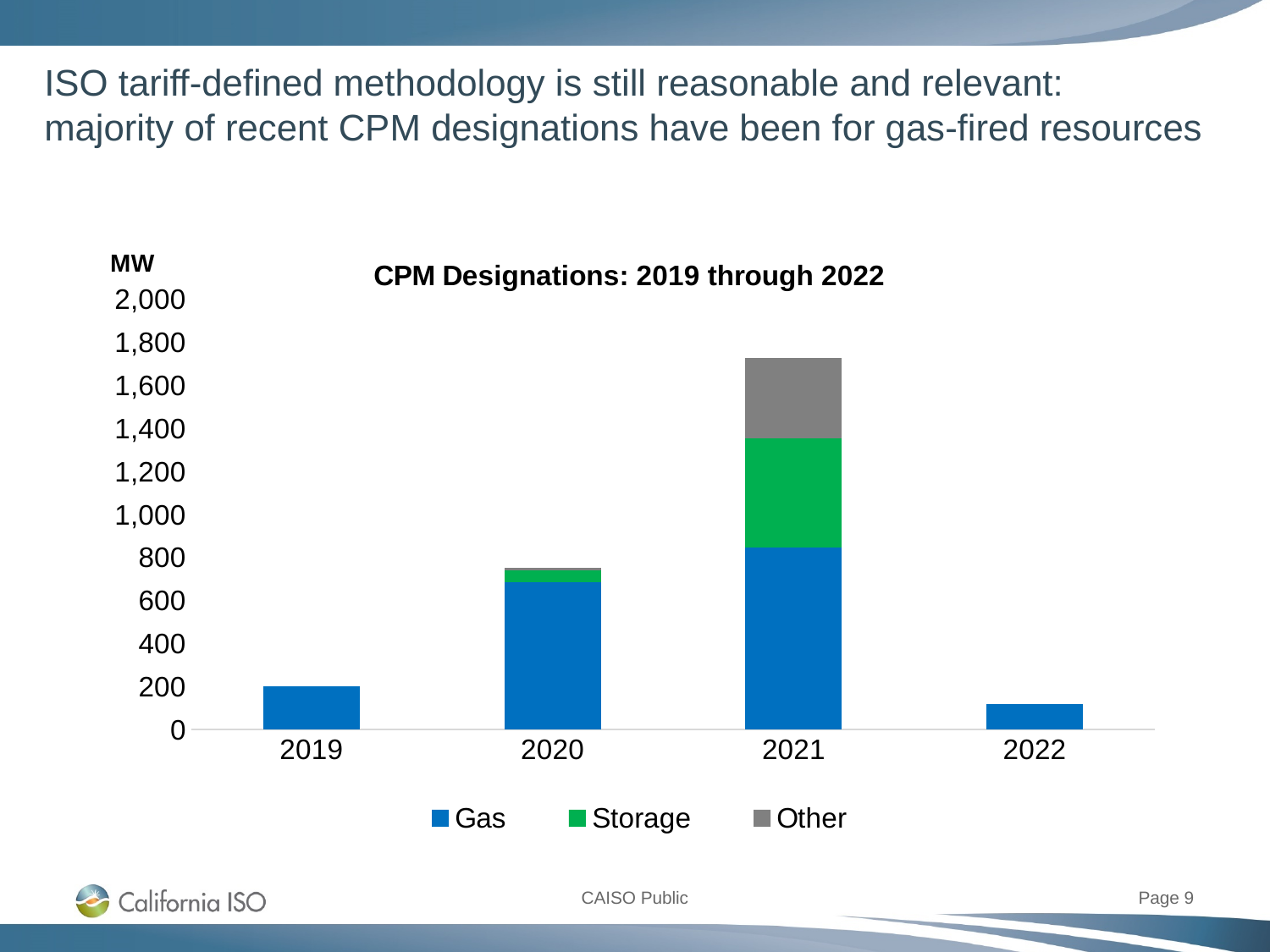
Which year has the shortest stacked bar? 2022 Is the total stacked value for 2021 greater or less than 1,600? greater Which series are listed in the legend? Gas, Storage, Other What type of chart is shown on the slide? Stacked bar chart Which year is the only one with a visible Storage segment larger than 200 MW? 2021 Is the Gas value for 2020 greater or less than 600? greater How many years are shown on the x axis? 4 Which is larger, the Gas value for 2019 or the Gas value for 2020? 2020 How many series does the legend list? 3 Which year has the tallest stacked bar? 2021 What is the title of the chart? CPM Designations: 2019 through 2022 Is the Gas value for 2022 greater or less than 200? less